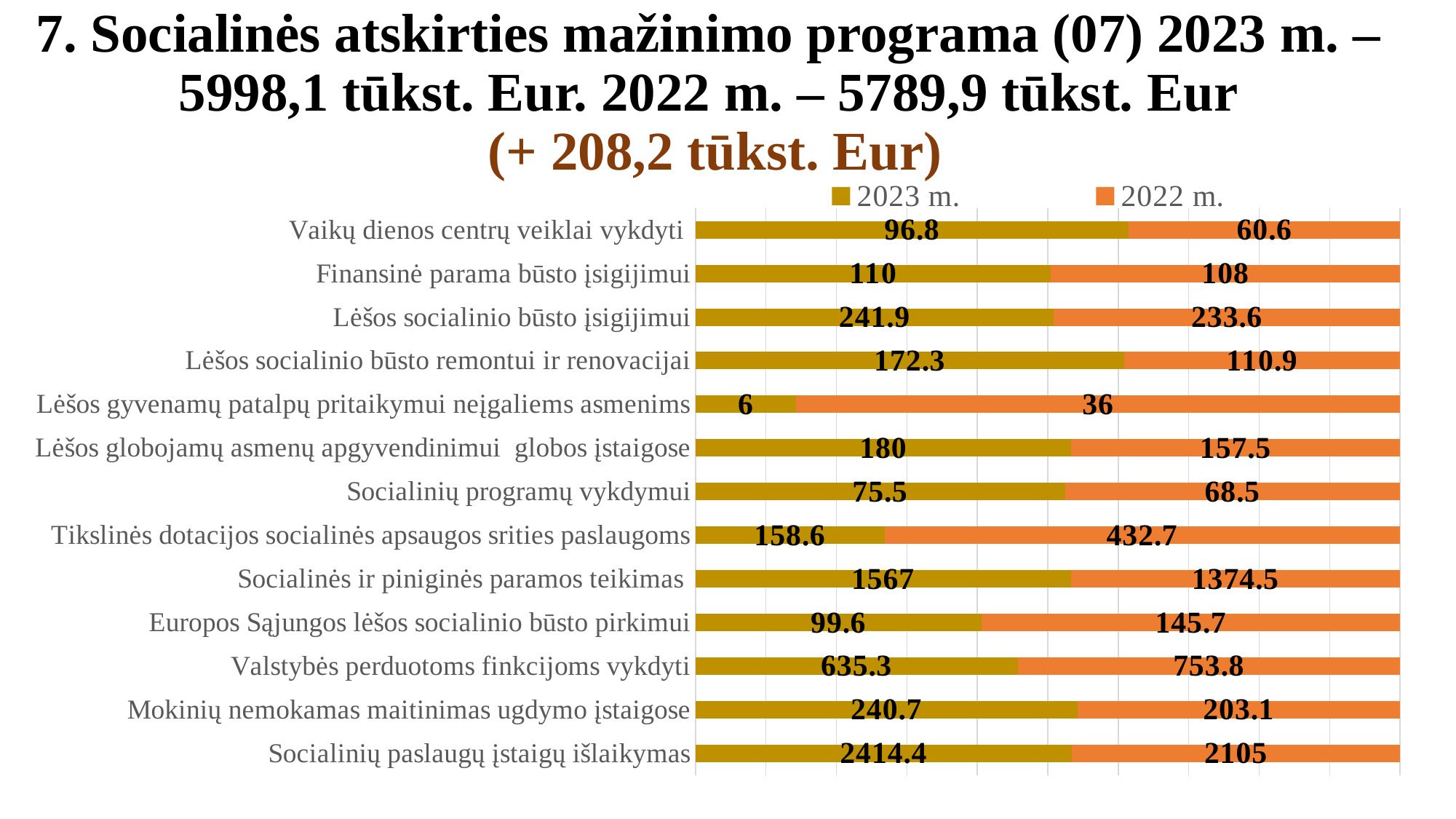
How many series does the legend list? 2 What is the 2023 m. value for Vaikų dienos centrų veiklai vykdyti? 96.8 Which category has the highest 2023 m. value? Socialinių paslaugų įstaigų išlaikymas What is the 2023 m. value for Socialinių paslaugų įstaigų išlaikymas? 2414.4 What is the difference between the 2022 m. and 2023 m. values for Valstybės perduotoms finkcijoms vykdyti? 118.5 What kind of chart is shown on the slide? Stacked bar chart Which category has the lowest 2023 m. value? Lėšos gyvenamų patalpų pritaikymui neįgaliems asmenims For Europos Sąjungos lėšos socialinio būsto pirkimui, which year has the larger value, 2023 m. or 2022 m.? 2022 m. What is the combined 2023 m. and 2022 m. value for Socialinių paslaugų įstaigų išlaikymas? 4519.4 What is the 2022 m. value for Tikslinės dotacijos socialinės apsaugos srities paslaugoms? 432.7 How many categories are shown on the chart? 13 What is the difference between the 2023 m. and 2022 m. values for Socialinės ir piniginės paramos teikimas? 192.5